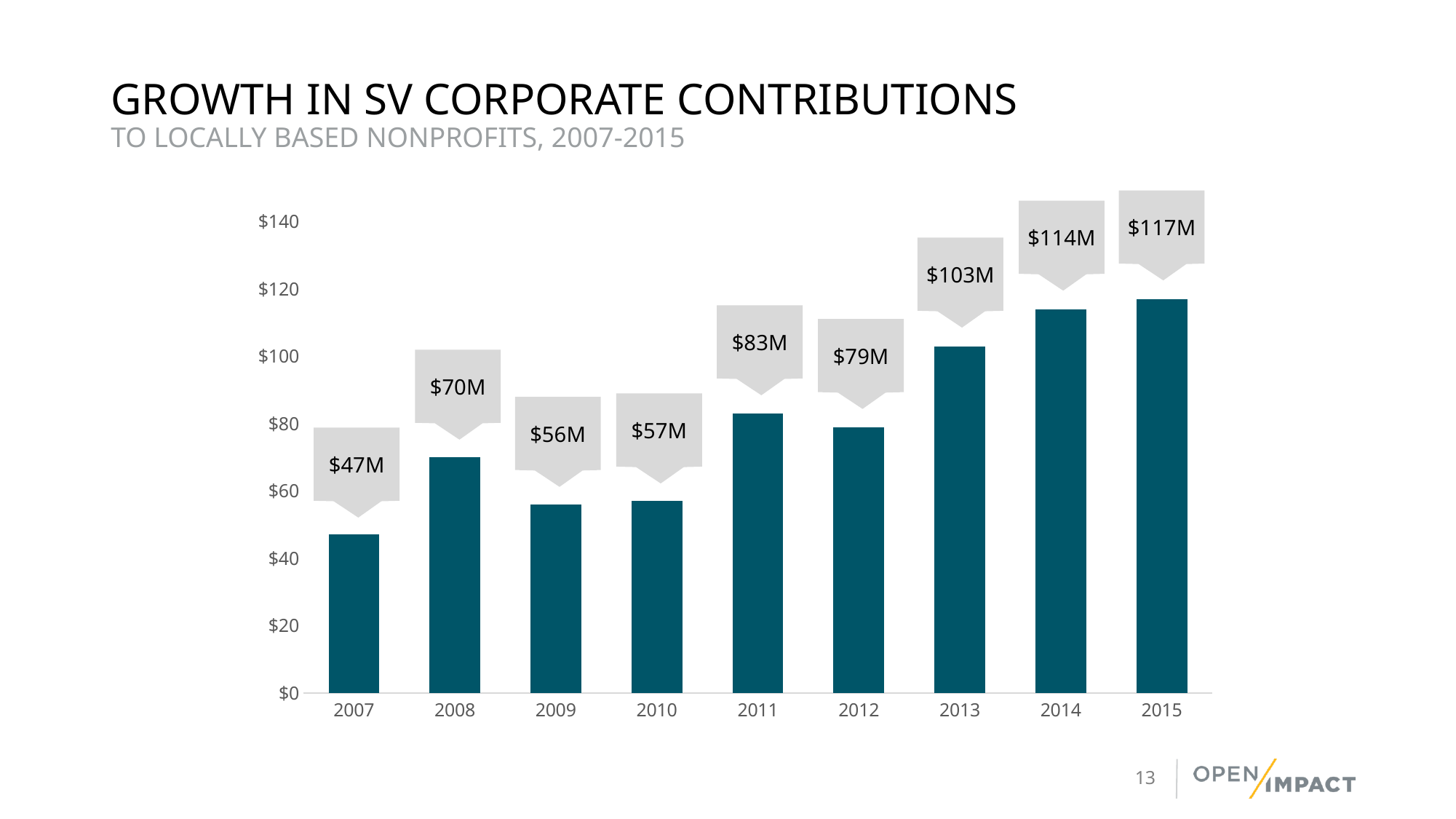
How many years are shown on the x axis? 9 What is the difference between the values for 2015 and 2007? $70M What is the difference between the values for 2012 and 2011? $4M What is the title of the chart on the slide? Growth in SV Corporate Contributions to Locally Based Nonprofits, 2007-2015 Which is larger, the value for 2011 or the value for 2012? 2011 Is the value for 2014 greater or less than $100? greater What is the value for 2013? $103M What kind of chart is shown on the slide? bar chart What is the value for 2010? $57M Which year has the highest value? 2015 Which year has the lowest value? 2007 What is the value for 2007? $47M